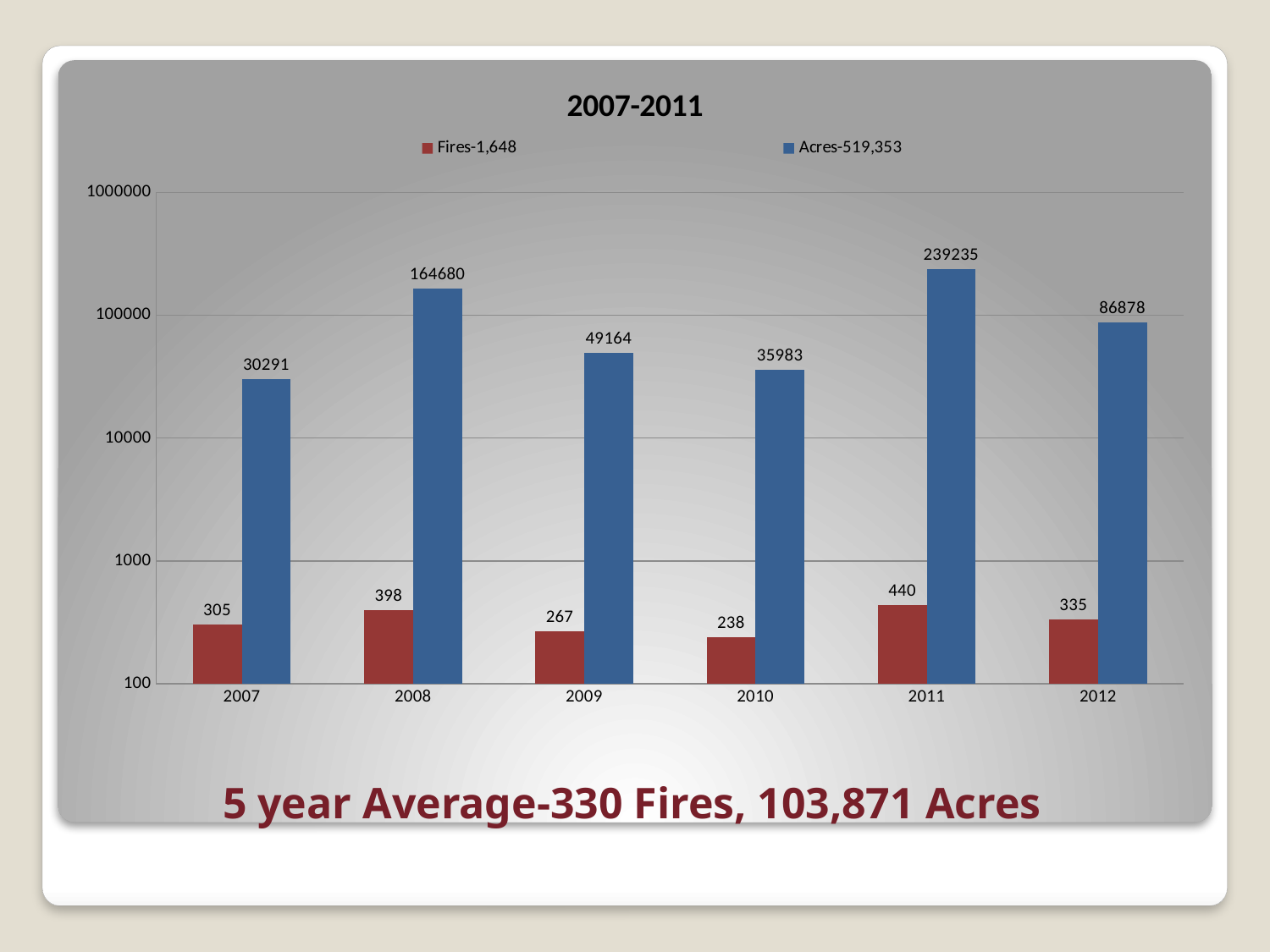
How many series does the legend list? 2 What is the value for Fires in 2008? 398 What kind of chart is shown on the slide? bar chart What is the value for Acres in 2010? 35983 What is the difference between the Fires values for 2011 and 2010? 202 Which is larger, the Acres value for 2008 or for 2012? 2008 Which year has the lowest value for Fires? 2010 What is the title of the chart? 2007-2011 Which year has the highest value for Acres? 2011 Is the value for Acres in 2007 greater or less than 100000? less What is the value for Acres in 2011? 239235 How many years are shown on the x axis? 6